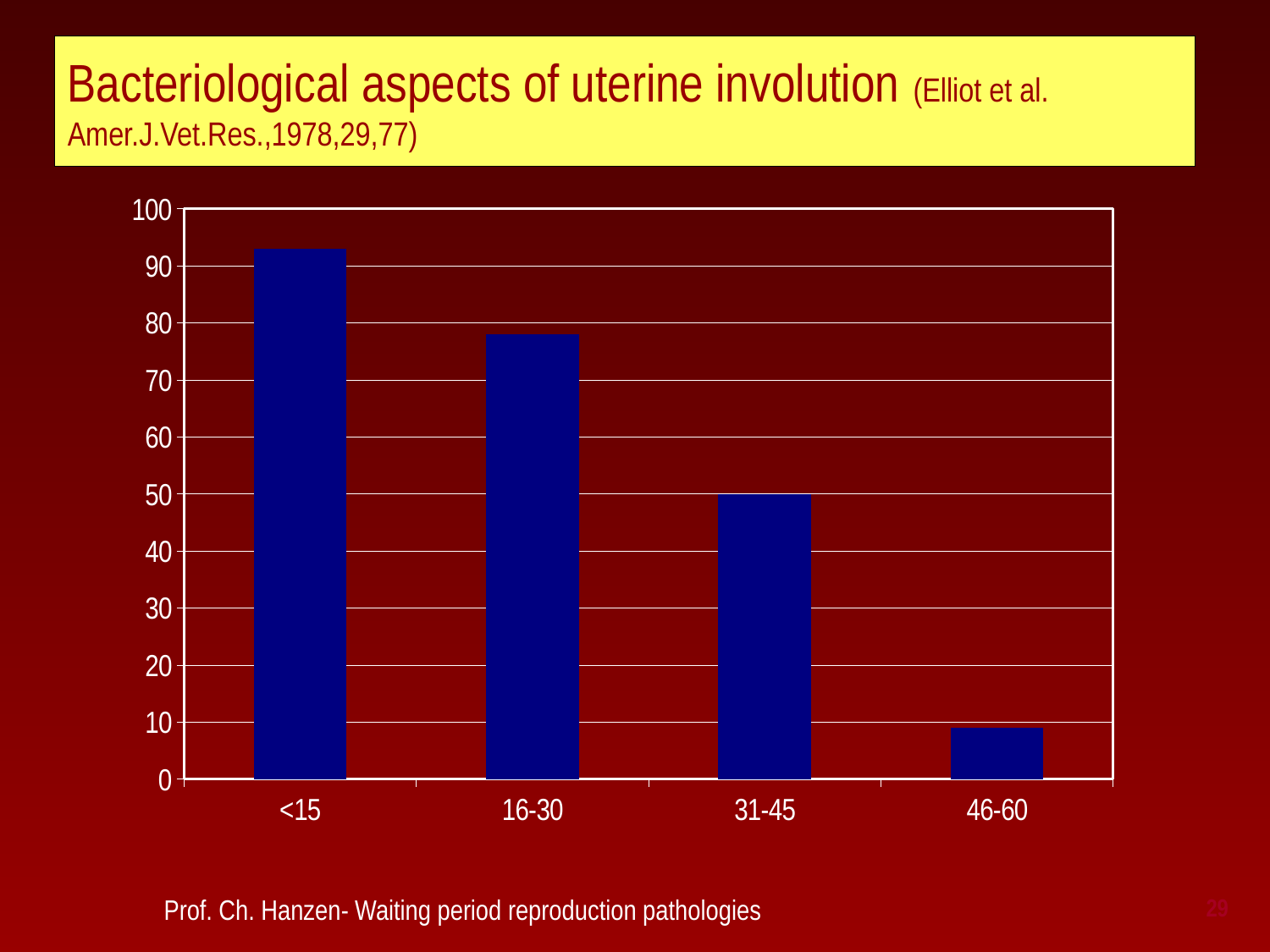
Do the values rise or fall from left to right along the x axis? fall Which category has the highest bar? <15 Is the value for 16-30 greater or less than 70? greater What kind of chart is shown on the slide? bar chart Which is larger, the value for 31-45 or the value for 46-60? 31-45 Which is larger, the value for <15 or the value for 16-30? <15 Which category has the lowest bar? 46-60 What is the title of the slide containing the chart? Bacteriological aspects of uterine involution Is the value for 16-30 greater or less than 80? less How many categories are shown on the x axis of the chart? 4 Is the value for 46-60 greater or less than 10? less